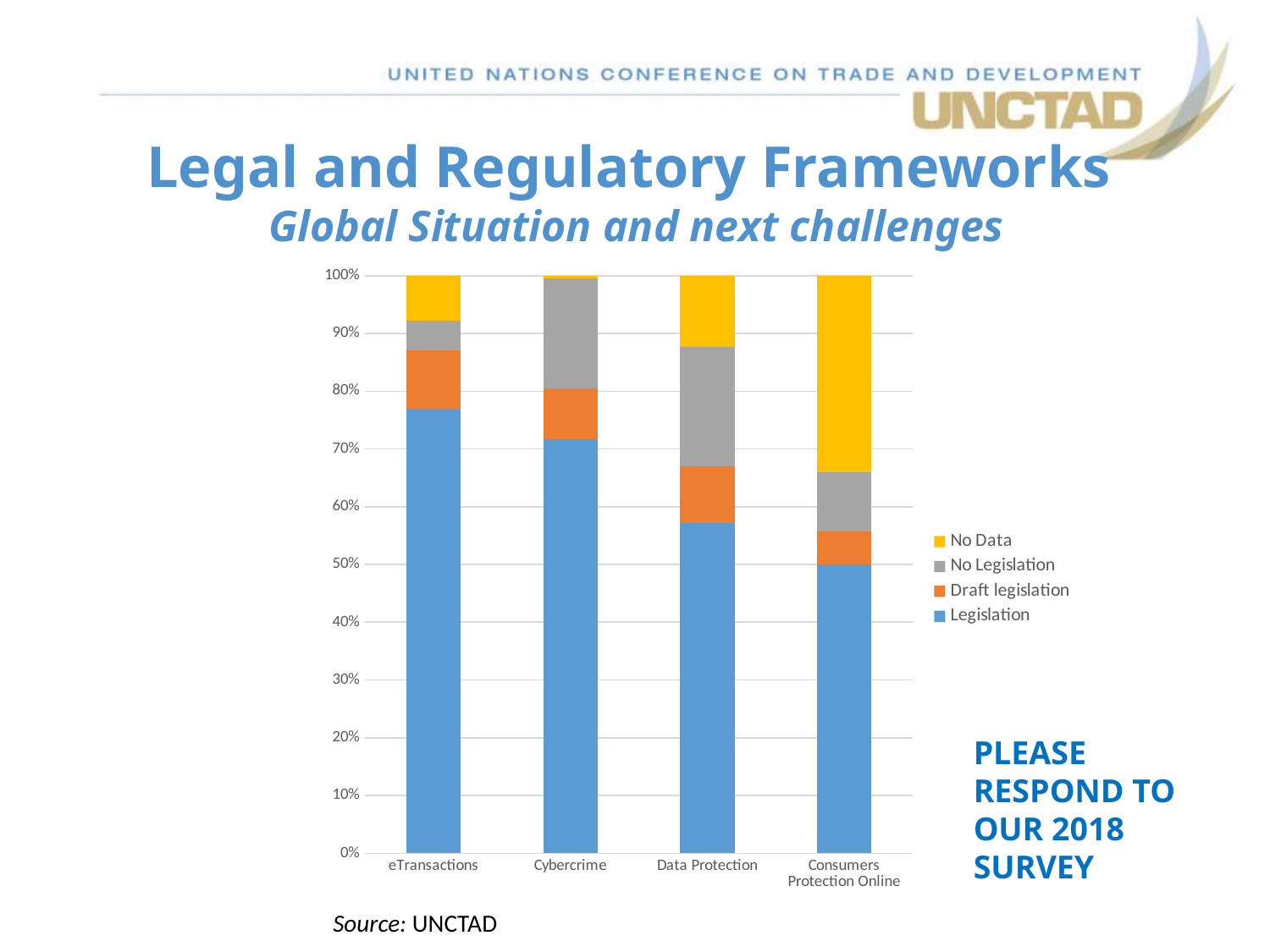
Does the Legislation share rise or fall moving from eTransactions to Consumers Protection Online along the x axis? Fall How many series does the chart's legend list? 4 What kind of chart is shown on the slide? Stacked bar chart Is the Legislation value for Consumers Protection Online greater or less than 60%? less Is the Legislation value for eTransactions greater or less than 70%? greater Which legend entry is shown in yellow? No Data Which has a larger Legislation share, Cybercrime or Data Protection? Cybercrime Which category has the smallest No Data share? Cybercrime Which category has the largest No Data share? Consumers Protection Online Which category has the smallest Legislation share? Consumers Protection Online Which category has the largest Legislation share? eTransactions How many categories are shown on the x axis of the chart? 4